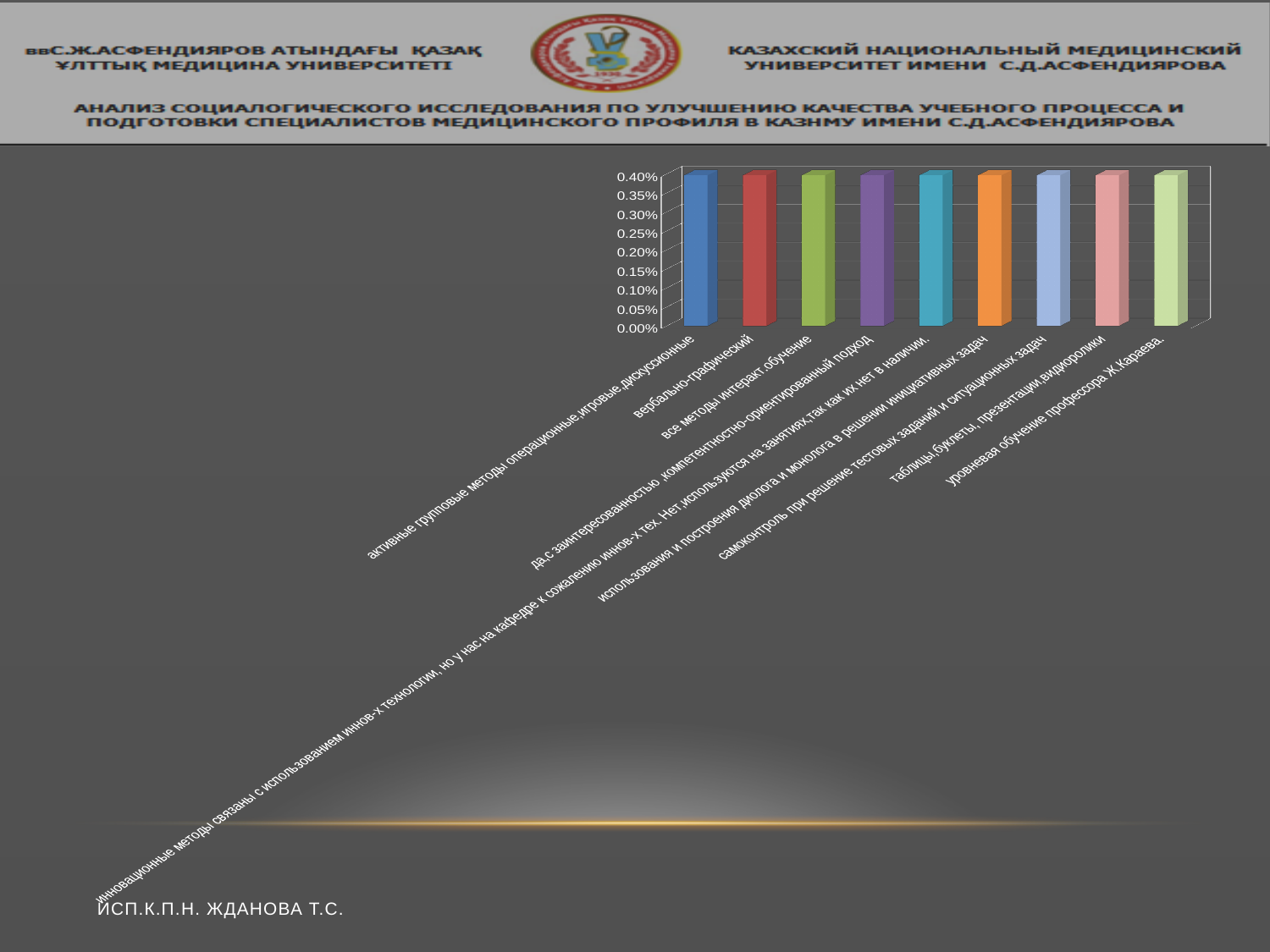
What is the highest tick value shown on the vertical axis of the chart? 0.40% Do the bar heights rise, fall, or stay roughly the same across the categories from left to right? stay roughly the same What colour is the first (leftmost) bar in the chart? blue Is the value for "самоконтроль при решение тестовых заданий и ситуационных задач" greater or less than 0.15%? greater How many bars (categories) does the chart show? 9 Is the value for "все методы интеракт.обучение" greater or less than 0.10%? greater Is the value for "уровневая обучение профессора Ж.Караева." greater or less than 0.25%? greater What kind of chart is shown on the slide? bar chart